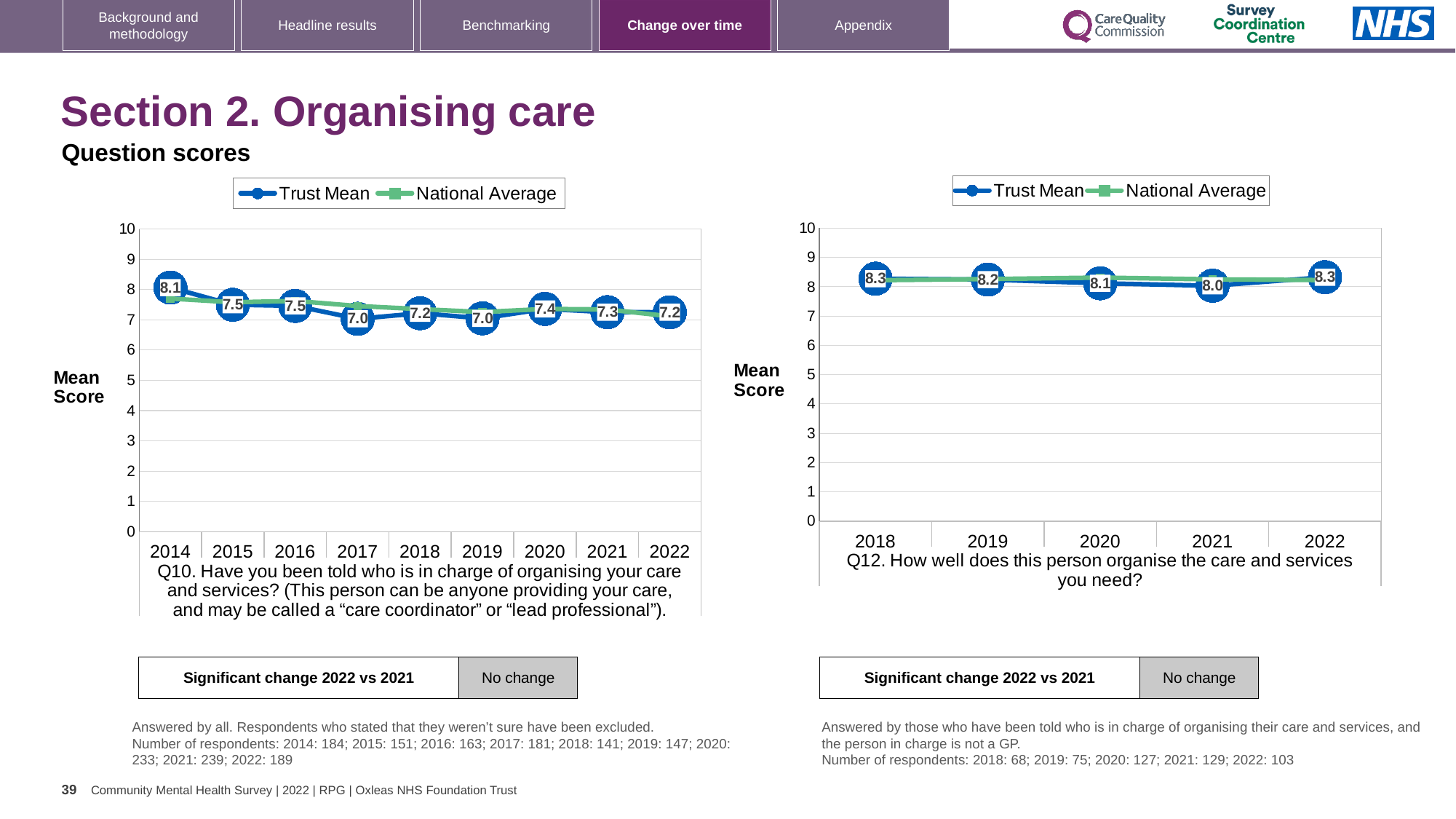
In the Q10 chart on the left, which year has the highest Trust Mean? 2014 In the Q12 chart on the right, which year has the lowest Trust Mean? 2021 In the Q10 chart on the left, how many years are plotted on the x axis? 9 In the Q12 chart on the right, is the Trust Mean for 2019 larger than the Trust Mean for 2020? Yes In the Q10 chart on the left, what is the difference between the Trust Mean in 2014 and in 2017? 1.1 In the Q12 chart on the right, what is the Trust Mean for 2021? 8.0 In the Q10 chart on the left, what is the Trust Mean for 2014? 8.1 In the Q12 chart on the right, does the Trust Mean rise or fall from 2018 to 2021? Fall In the Q10 chart on the left, is the Trust Mean for 2019 greater or less than 8? less What kind of chart is the Q12 chart on the right? Line chart In the Q12 chart on the right, how many series does the legend list? 2 In the Q10 chart on the left, what is the Trust Mean for 2022? 7.2